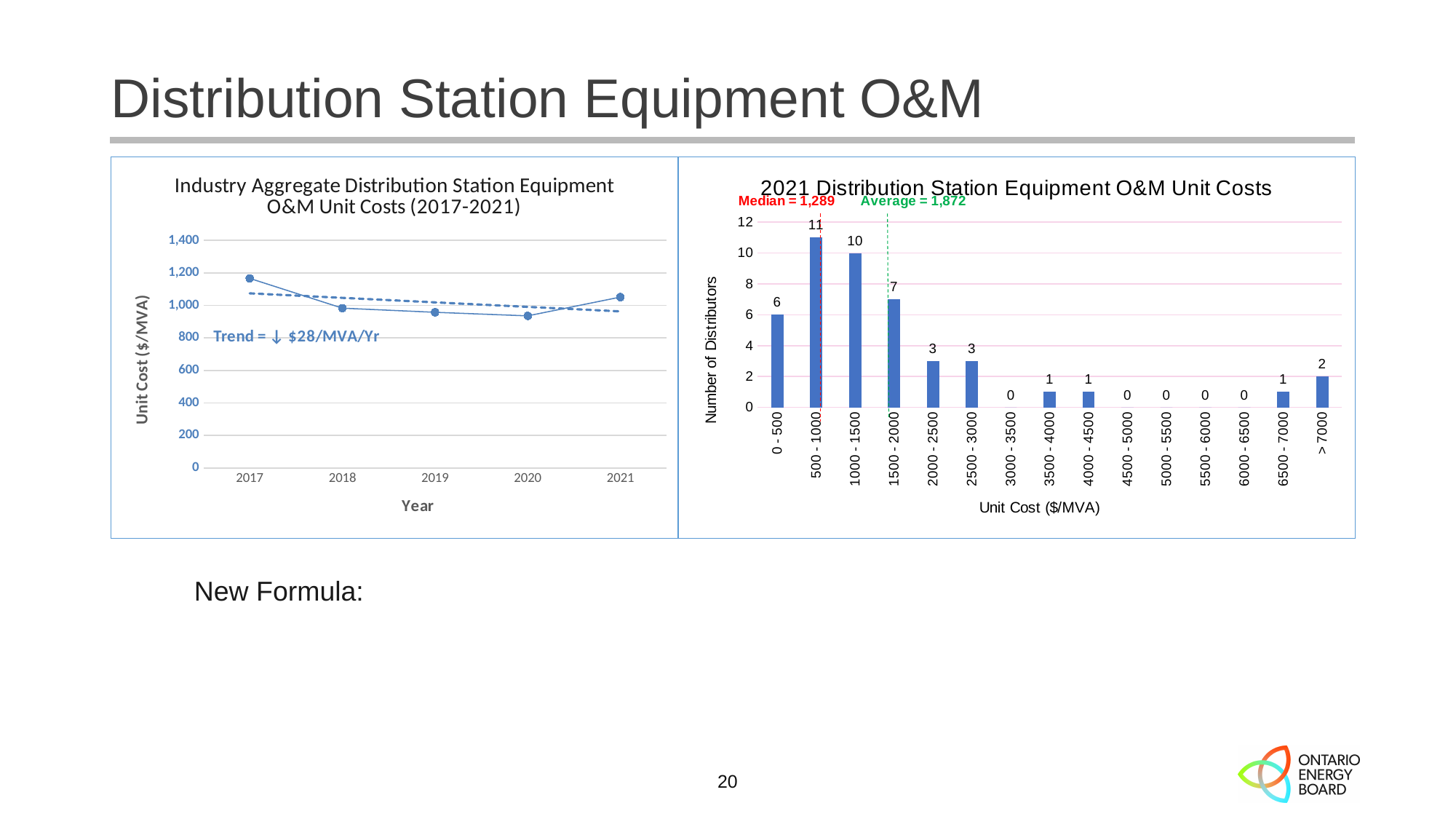
In the chart titled '2021 Distribution Station Equipment O&M Unit Costs', what is the difference between the number of distributors in the 0 - 500 bin and the 2000 - 2500 bin? 3 In the chart titled '2021 Distribution Station Equipment O&M Unit Costs', how many distributors are in the 1500 - 2000 bin? 7 What kind of chart is the chart on the left of the slide, titled 'Industry Aggregate Distribution Station Equipment O&M Unit Costs (2017-2021)'? line chart In the chart titled '2021 Distribution Station Equipment O&M Unit Costs', how many unit cost bins are shown on the x axis? 15 In the chart titled '2021 Distribution Station Equipment O&M Unit Costs', what median value is annotated on the chart? 1,289 In the chart titled 'Industry Aggregate Distribution Station Equipment O&M Unit Costs (2017-2021)', which year has the highest unit cost? 2017 In the chart titled 'Industry Aggregate Distribution Station Equipment O&M Unit Costs (2017-2021)', is the unit cost for 2020 greater or less than 1,000? less In the chart titled '2021 Distribution Station Equipment O&M Unit Costs', which unit cost bin has the most distributors? 500 - 1000 In the chart titled '2021 Distribution Station Equipment O&M Unit Costs', how many distributors are in the 500 - 1000 bin? 11 In the chart titled '2021 Distribution Station Equipment O&M Unit Costs', how many distributors are in the > 7000 bin? 2 In the chart titled '2021 Distribution Station Equipment O&M Unit Costs', which bin has more distributors, 1000 - 1500 or 2500 - 3000? 1000 - 1500 In the chart titled 'Industry Aggregate Distribution Station Equipment O&M Unit Costs (2017-2021)', how many years are plotted? 5